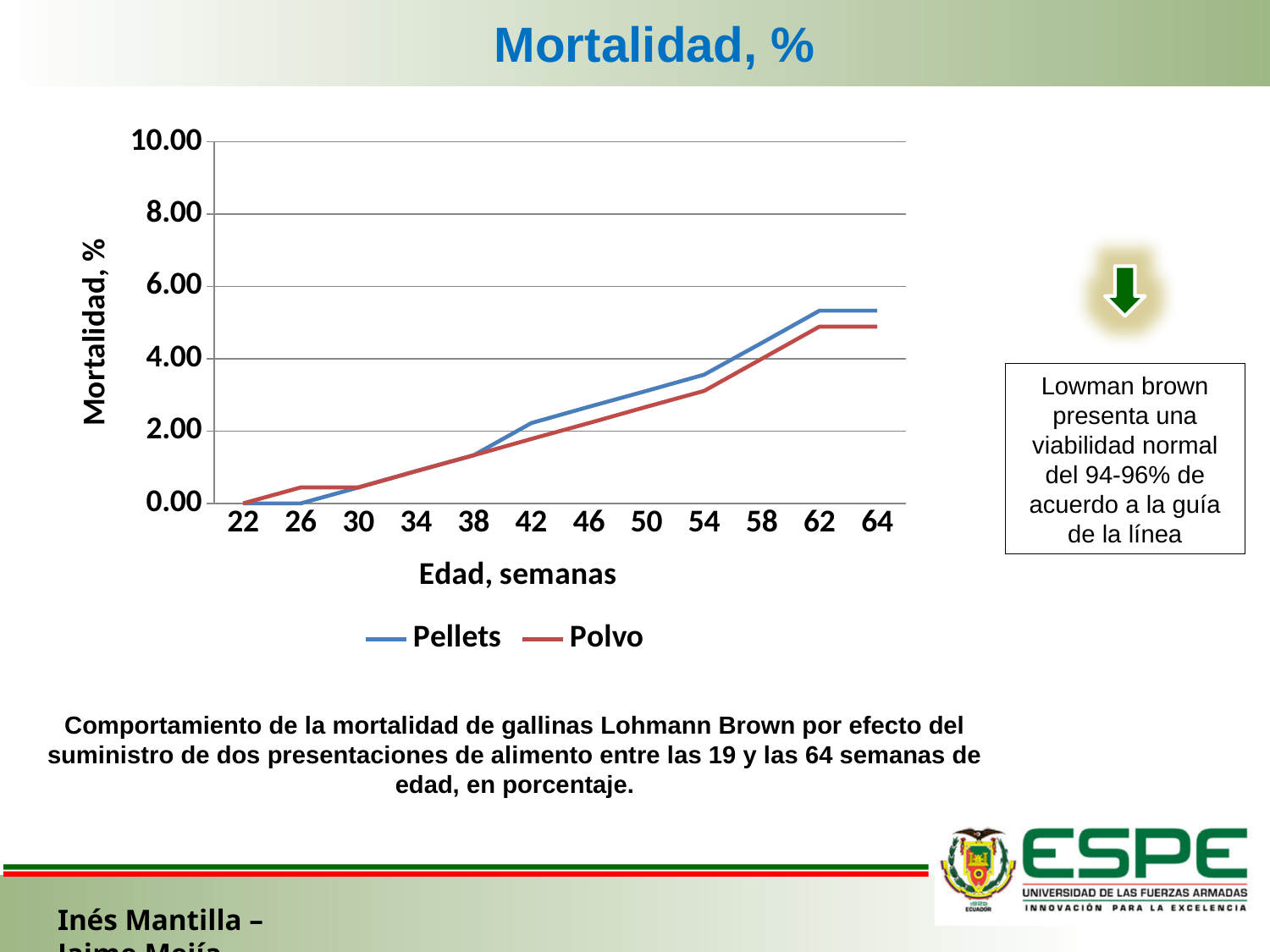
At 62 semanas, which series has the higher mortality, Pellets or Polvo? Pellets How many age points (semanas) are shown along the x axis? 12 Is the value for Pellets at 62 semanas greater or less than 4.00? greater Do the mortality values for Pellets rise or fall as age increases along the x axis? rise Is the value for Polvo at 64 semanas greater or less than 4.00? greater What is the title of the y axis? Mortalidad, % How many series does the legend list? 2 Is the value for Polvo at 54 semanas greater or less than 4.00? less Which colour is used for the Polvo series? red At 26 semanas, which series has the higher mortality, Pellets or Polvo? Polvo What kind of chart is shown on the slide? line chart